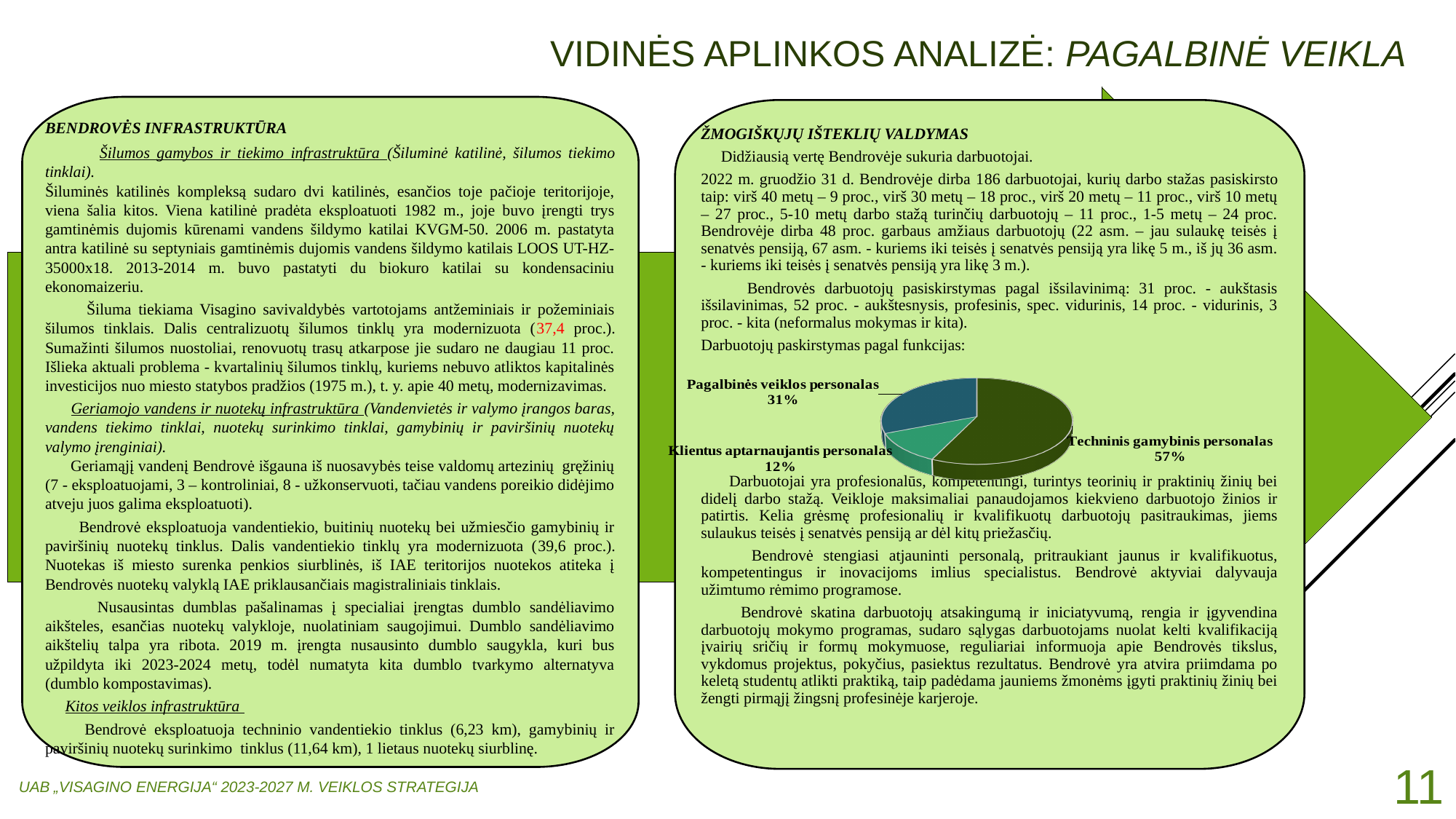
Which category has the smallest slice of the pie? Klientus aptarnaujantis personalas Which is larger, the slice for Techninis gamybinis personalas or the slice for Pagalbinės veiklos personalas? Techninis gamybinis personalas What kind of chart is shown on the slide? pie chart How many slices does the pie chart have? 3 What does the text directly above the pie chart say the chart shows? Darbuotojų paskirstymas pagal funkcijas What share of the pie does Klientus aptarnaujantis personalas have? 12% Which category has the largest slice of the pie? Techninis gamybinis personalas What share of the pie does Techninis gamybinis personalas have? 57% What is the difference in percentage points between Pagalbinės veiklos personalas and Klientus aptarnaujantis personalas? 19 What share of the pie does Pagalbinės veiklos personalas have? 31% Which is larger, the slice for Pagalbinės veiklos personalas or the slice for Klientus aptarnaujantis personalas? Pagalbinės veiklos personalas What is the difference in percentage points between Techninis gamybinis personalas and Pagalbinės veiklos personalas? 26